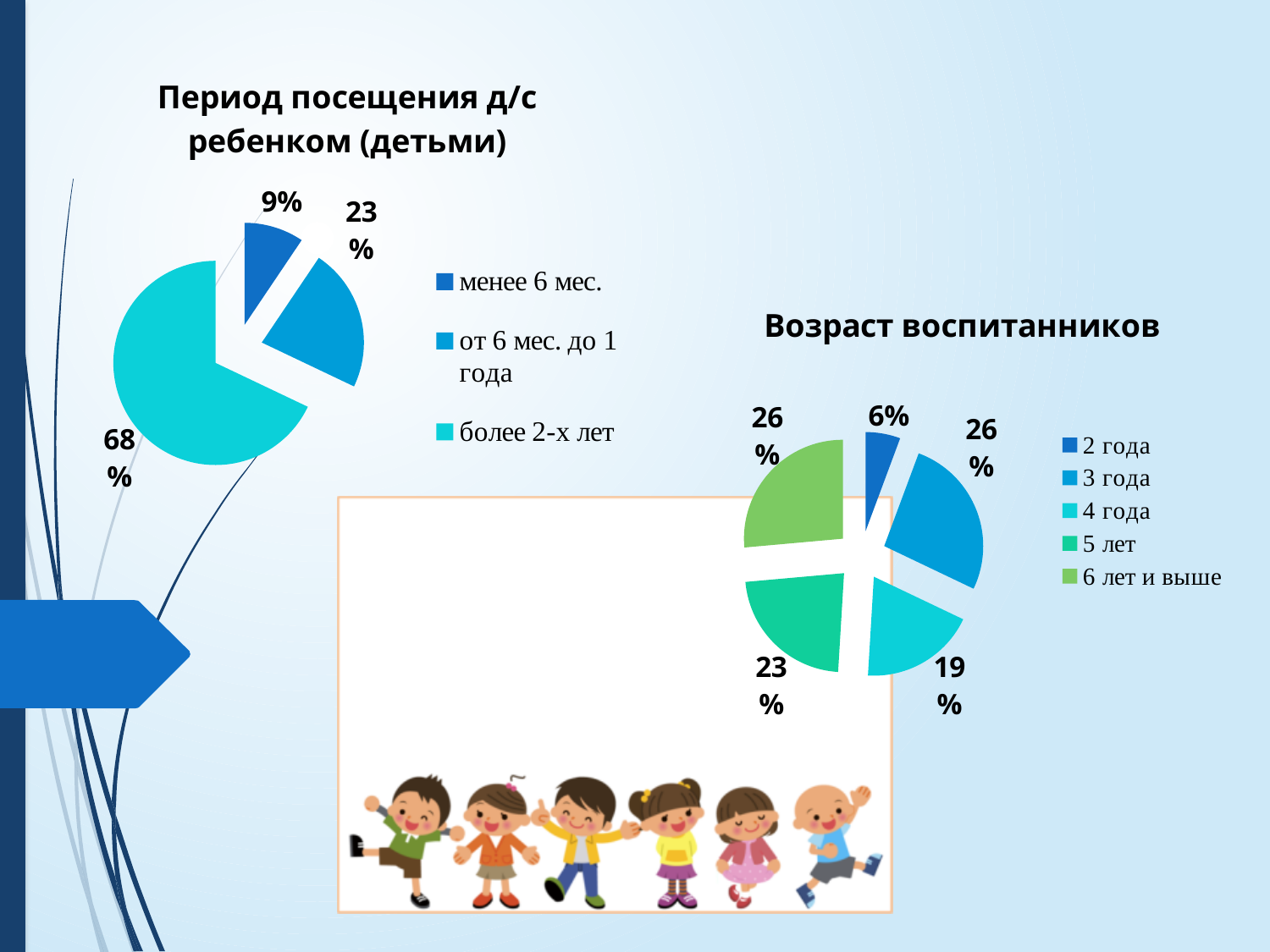
In the chart titled "Возраст воспитанников", what share is labelled for "5 лет"? 23% In the chart titled "Возраст воспитанников", which is larger: the share for "5 лет" or the share for "4 года"? 5 лет In the chart titled "Возраст воспитанников", what share is labelled for "4 года"? 19% In the chart titled "Период посещения д/с ребенком (детьми)", how many categories does the legend list? 3 In the chart titled "Возраст воспитанников", which category has the smallest slice? 2 года In the chart titled "Период посещения д/с ребенком (детьми)", which category has the smallest slice? менее 6 мес. In the chart titled "Период посещения д/с ребенком (детьми)", which category has the largest slice? более 2-х лет In the chart titled "Возраст воспитанников", how many categories does the legend list? 5 In the chart titled "Период посещения д/с ребенком (детьми)", what share is labelled for "более 2-х лет"? 68% In the chart titled "Период посещения д/с ребенком (детьми)", what is the difference in percentage points between "от 6 мес. до 1 года" and "менее 6 мес."? 14 What kind of chart is the one titled "Возраст воспитанников"? pie chart In the chart titled "Период посещения д/с ребенком (детьми)", what share is labelled for "менее 6 мес."? 9%